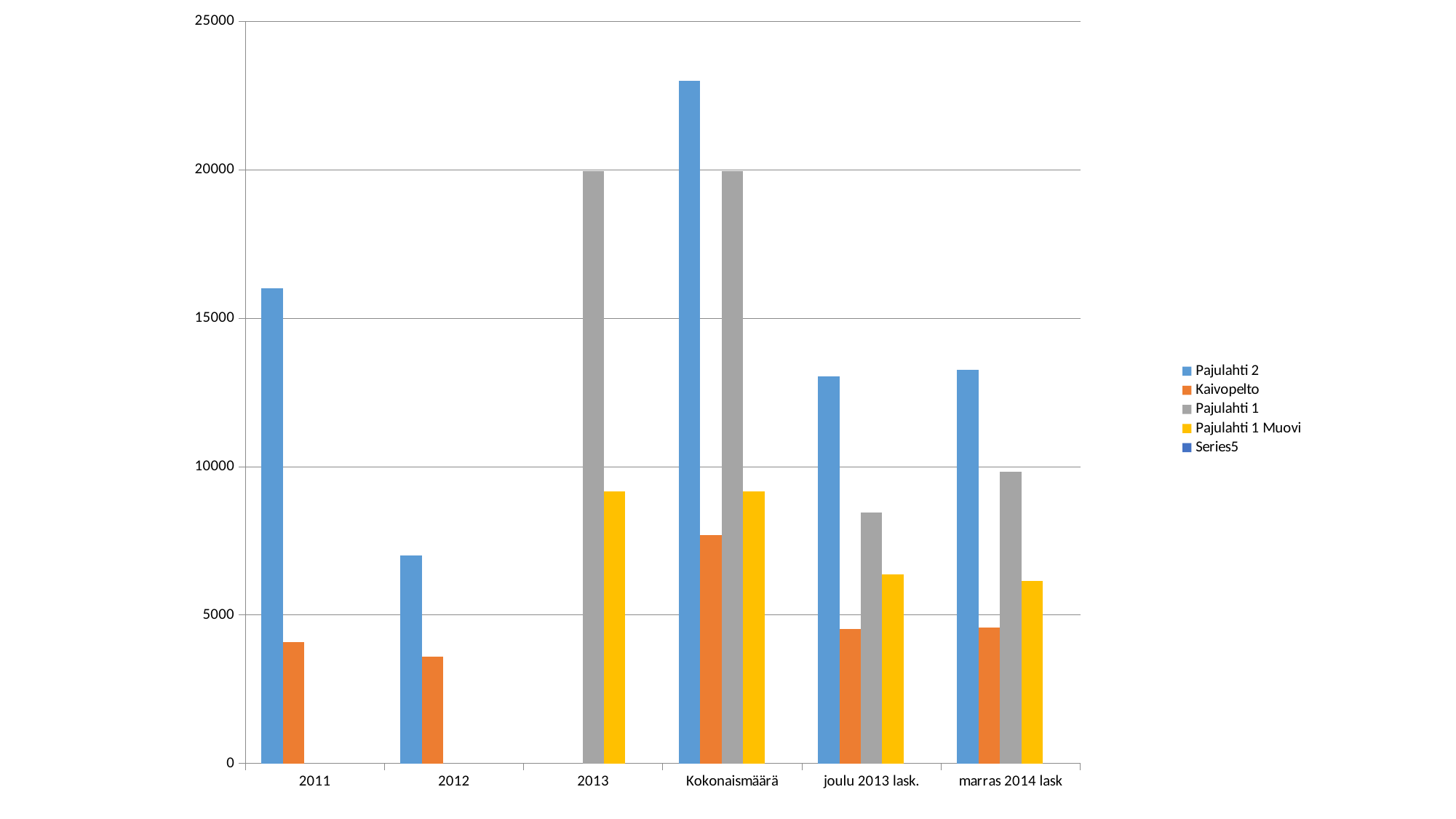
How many series does the legend list? 5 In 2011, which is larger: Pajulahti 2 or Kaivopelto? Pajulahti 2 Is the value for Pajulahti 2 in 2011 greater or less than 15000? greater For Pajulahti 1, which is larger: joulu 2013 lask. or marras 2014 lask? marras 2014 lask How many categories are shown on the x axis? 6 Is the value for Kaivopelto in 2012 greater or less than 5000? less What kind of chart is shown on the slide? bar chart Is the value for Pajulahti 2 in Kokonaismäärä greater or less than 20000? greater Which category has the tallest bar in the chart? Kokonaismäärä In which category is the Pajulahti 2 bar lowest? 2012